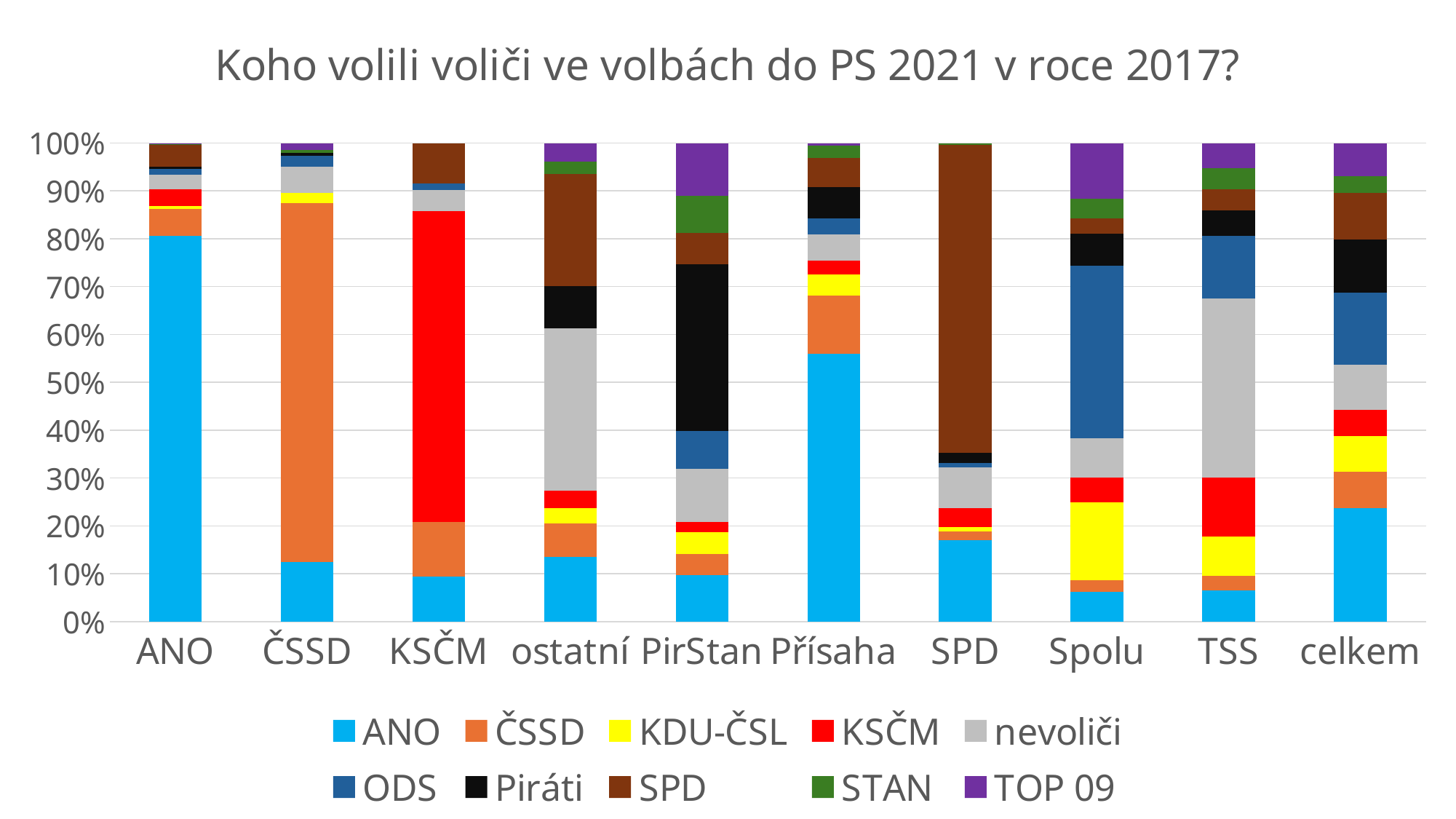
Is the ANO segment in the ČSSD bar greater or less than 20%? less Is the ANO segment in the Spolu bar greater or less than 10%? less What is the title of the chart? Koho volili voliči ve volbách do PS 2021 v roce 2017? What does each stacked bar total? 100% Which is larger: the ANO segment in the ANO bar or the ANO segment in the ČSSD bar? ANO bar How many series does the legend list? 10 Is the ANO segment in the Přísaha bar greater or less than 50%? greater Which category has the largest ANO segment? ANO How many categories are shown along the x axis? 10 Which colour represents SPD in the legend? brown What kind of chart is shown on the slide? stacked bar chart